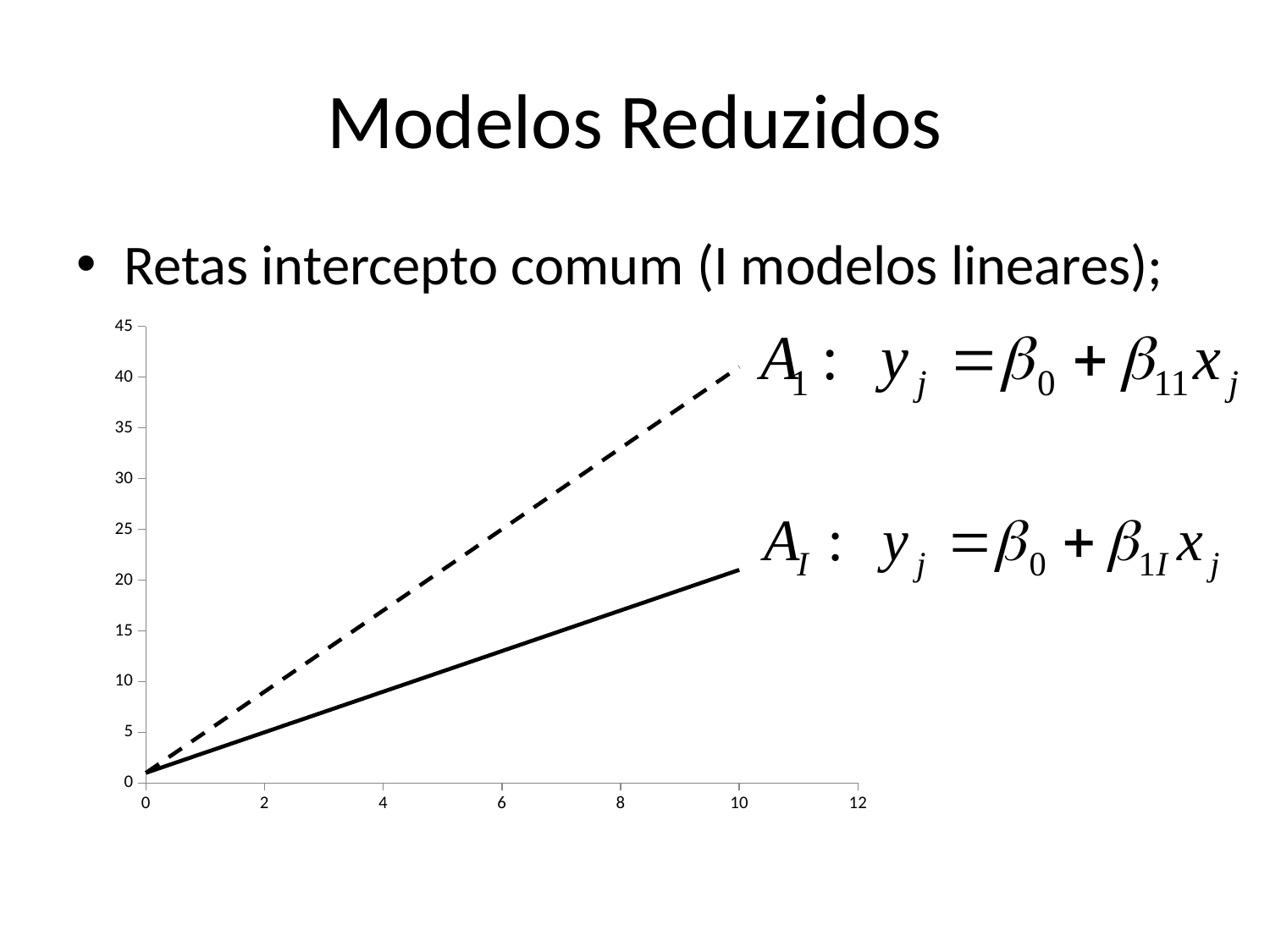
Is the value of the dashed line at x = 0 greater or less than 5? less Is the value of the dashed line at x = 10 greater or less than 35? greater At x = 10, which line has the higher value, the dashed line or the solid line? the dashed line Do the values of the solid line rise or fall as x increases? rise What kind of chart is shown on the slide? line chart Is the value of the solid line at x = 10 greater or less than 25? less What is the highest value labelled on the x axis? 12 How many lines are plotted on the chart? 2 What is the highest value labelled on the y axis? 45 Which of the two lines is steeper, the dashed line or the solid line? the dashed line Do the values of the dashed line rise or fall as x increases? rise